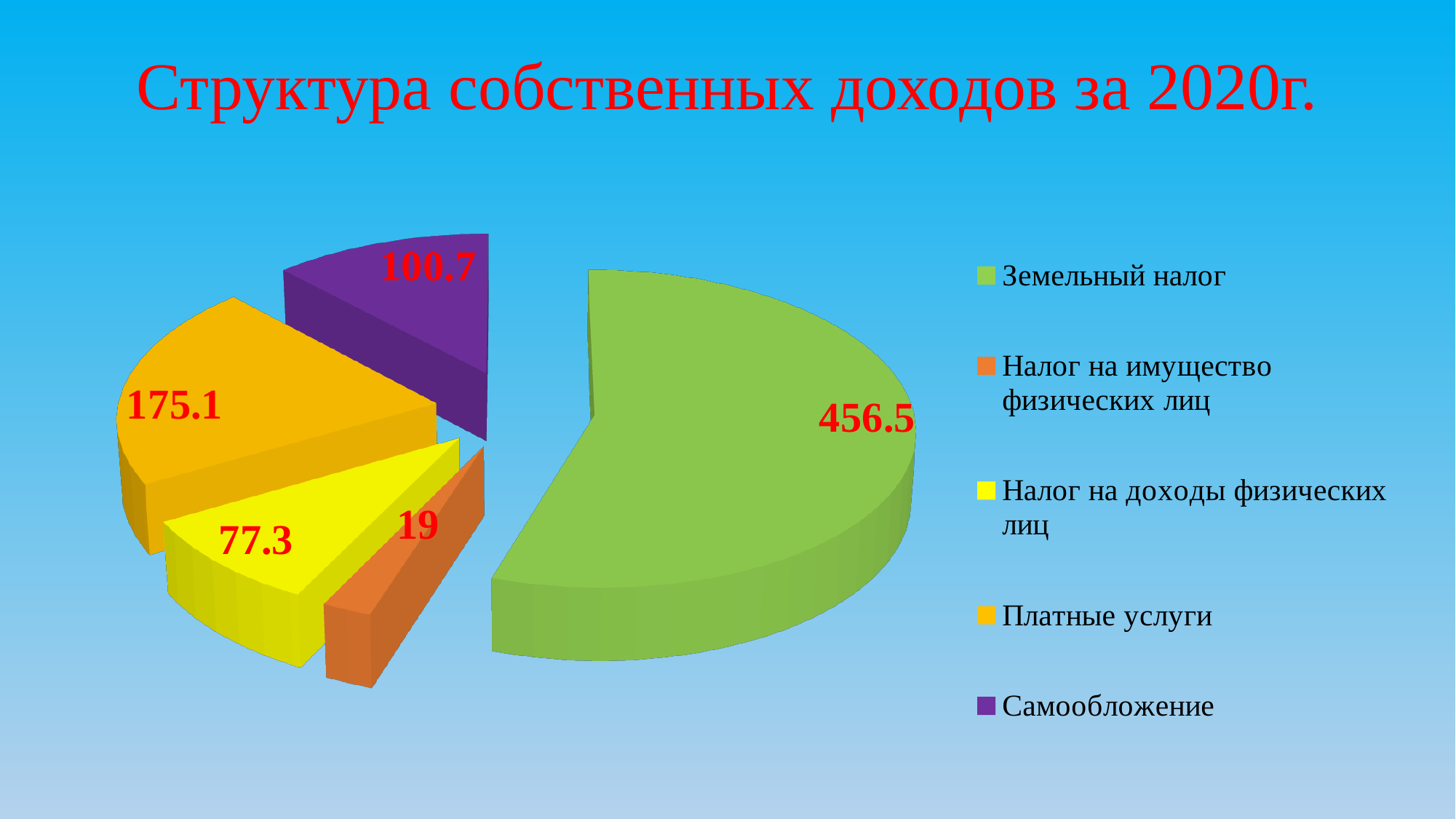
What is the difference between the values for Земельный налог and Платные услуги? 281.4 Which category has the smallest slice? Налог на имущество физических лиц What is the value for Налог на доходы физических лиц? 77.3 Which category has the largest slice? Земельный налог What is the value for Платные услуги? 175.1 What is the value for Налог на имущество физических лиц? 19 Which is larger, Самообложение or Налог на доходы физических лиц? Самообложение What is the value for Самообложение? 100.7 How many categories does the pie chart have? 5 What is the value for Земельный налог? 456.5 What is the difference between the values for Платные услуги and Самообложение? 74.4 What type of chart is shown on the slide? Pie chart